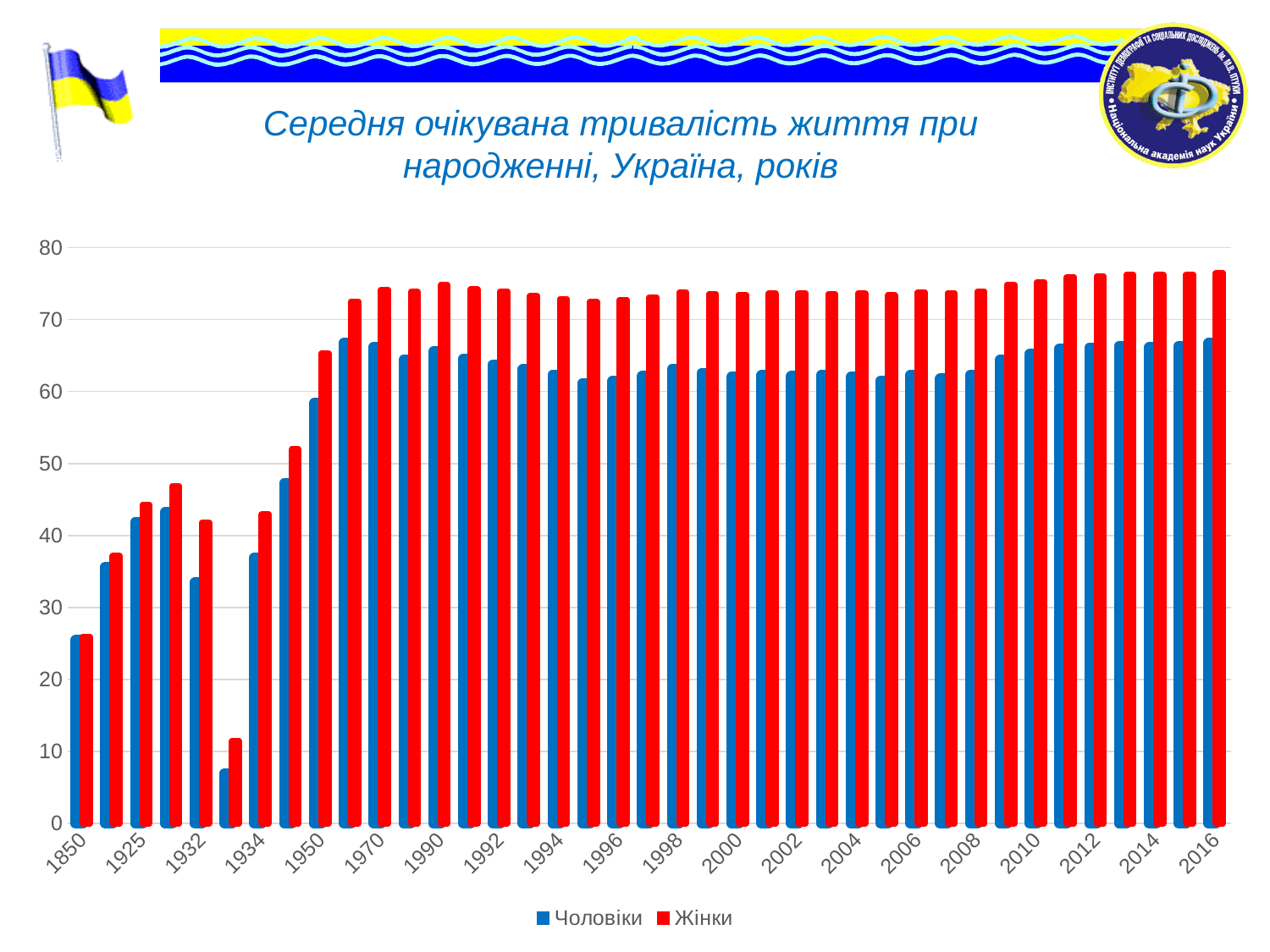
What is the title of the chart? Середня очікувана тривалість життя при народженні, Україна, років Do the values for Жінки rise or fall from 2008 to 2016? rise Is the value for Чоловіки in 1850 greater or less than 30? less Is the value for Чоловіки in 2016 greater or less than 70? less What kind of chart is shown on the slide? bar chart Is the value for Чоловіки in 1950 greater or less than 60? less In 2016, which series has the larger value, Чоловіки or Жінки? Жінки What are the two series named in the legend? Чоловіки and Жінки How many series does the legend list? 2